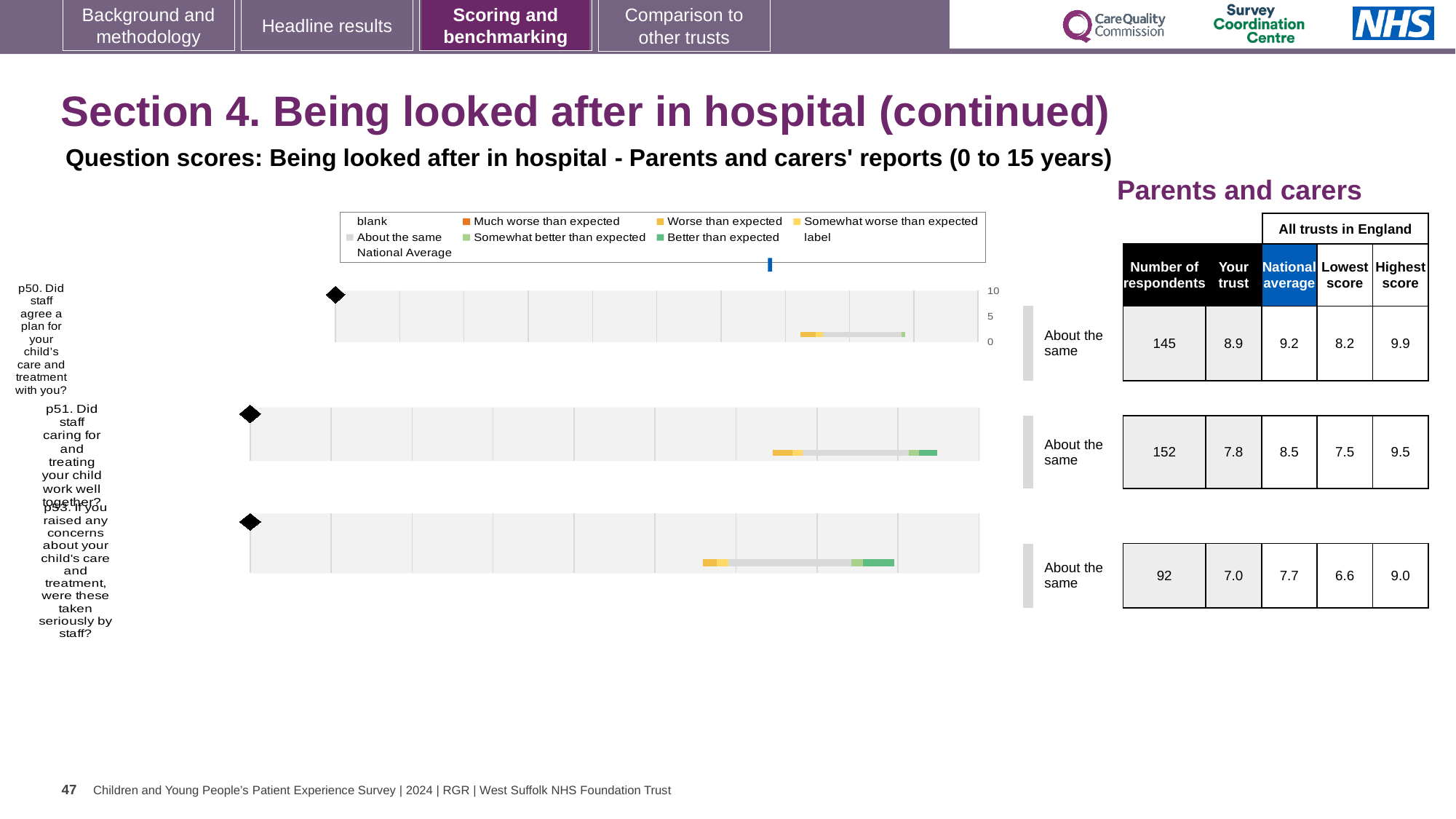
What benchmark category is shown next to the p50 chart? About the same For the p53 chart, what is the difference between the national average and the 'Your trust' score? 0.7 For the p51 chart, which is larger: the 'Your trust' score or the national average? national average For the p50 chart (staff agree a plan for your child's care), what is the 'Your trust' score shown in the table? 8.9 In the chart legend, what colour represents 'Better than expected'? green For the p53 chart (concerns taken seriously by staff), how many respondents are shown? 92 For the p51 chart (staff caring for your child work well together), what is the national average score? 8.5 Which question has the highest 'Your trust' score on this slide? p50 How many survey questions (p50, p51, p53) have a chart on this slide? 3 What is the highest tick value shown on the axis of the p50 chart? 10 What kind of chart is used to show the question scores on this slide? bar chart Which question has the lowest 'Your trust' score on this slide? p53